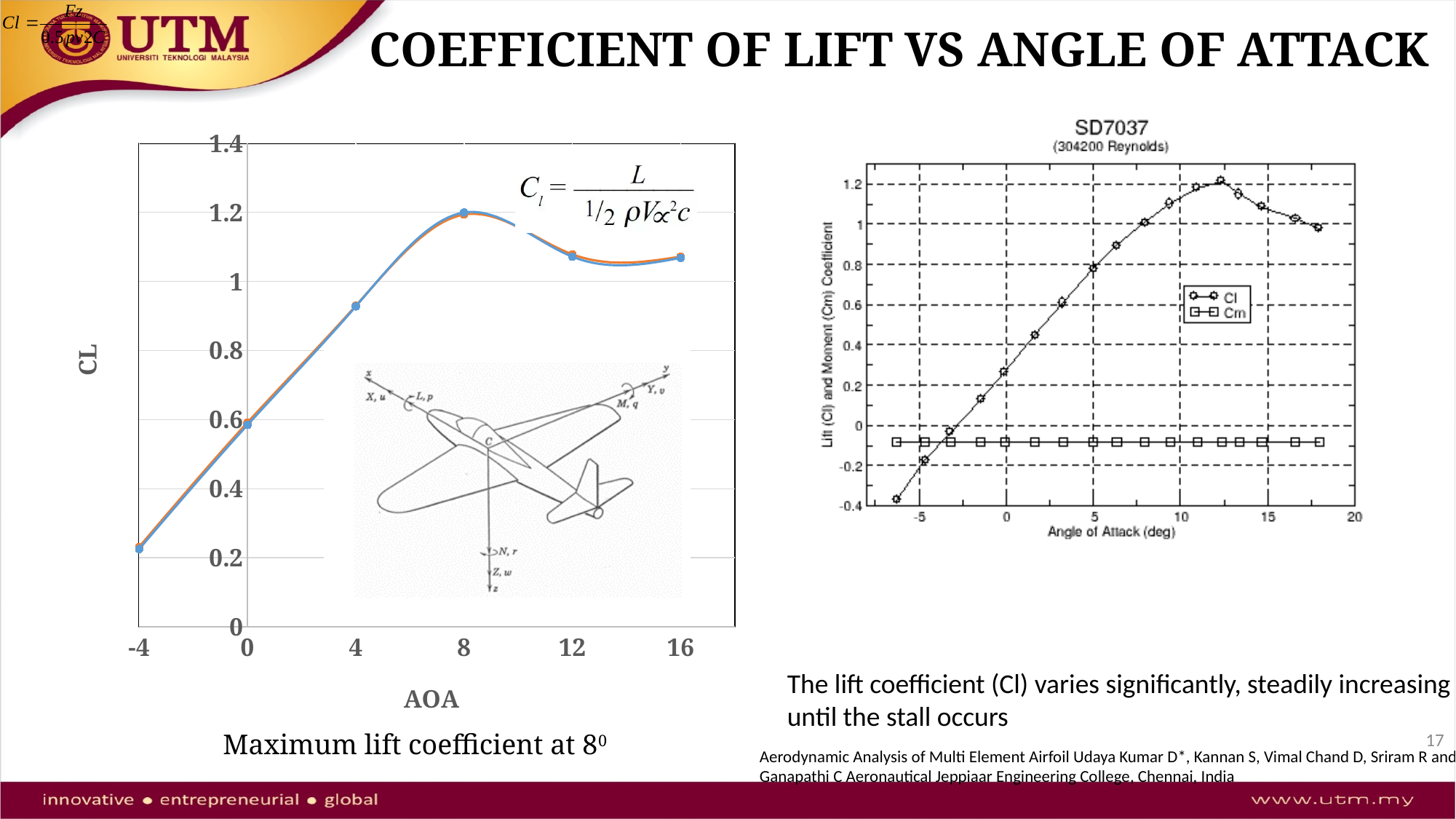
On the left chart (CL vs AOA), what kind of chart is it? line chart On the left chart (CL vs AOA), at which AOA value is CL highest? 8 On the left chart, what is the label of the vertical axis? CL On the left chart (CL vs AOA), which has the larger CL value: AOA 0 or AOA 4? AOA 4 On the right chart (SD7037), how many series does the legend list? 2 On the right chart (SD7037), is the Cl value at an angle of attack of 5 deg greater or less than 0.6? greater On the left chart (CL vs AOA), at which AOA value is CL lowest? -4 On the left chart (CL vs AOA), is the CL value at AOA 12 greater or less than 1? greater On the left chart (CL vs AOA), is the CL value at AOA -4 greater or less than 0.4? less On the left chart (CL vs AOA), does CL rise or fall as AOA increases from -4 to 8? rise On the left chart (CL vs AOA), how many data points are plotted along the AOA axis? 6